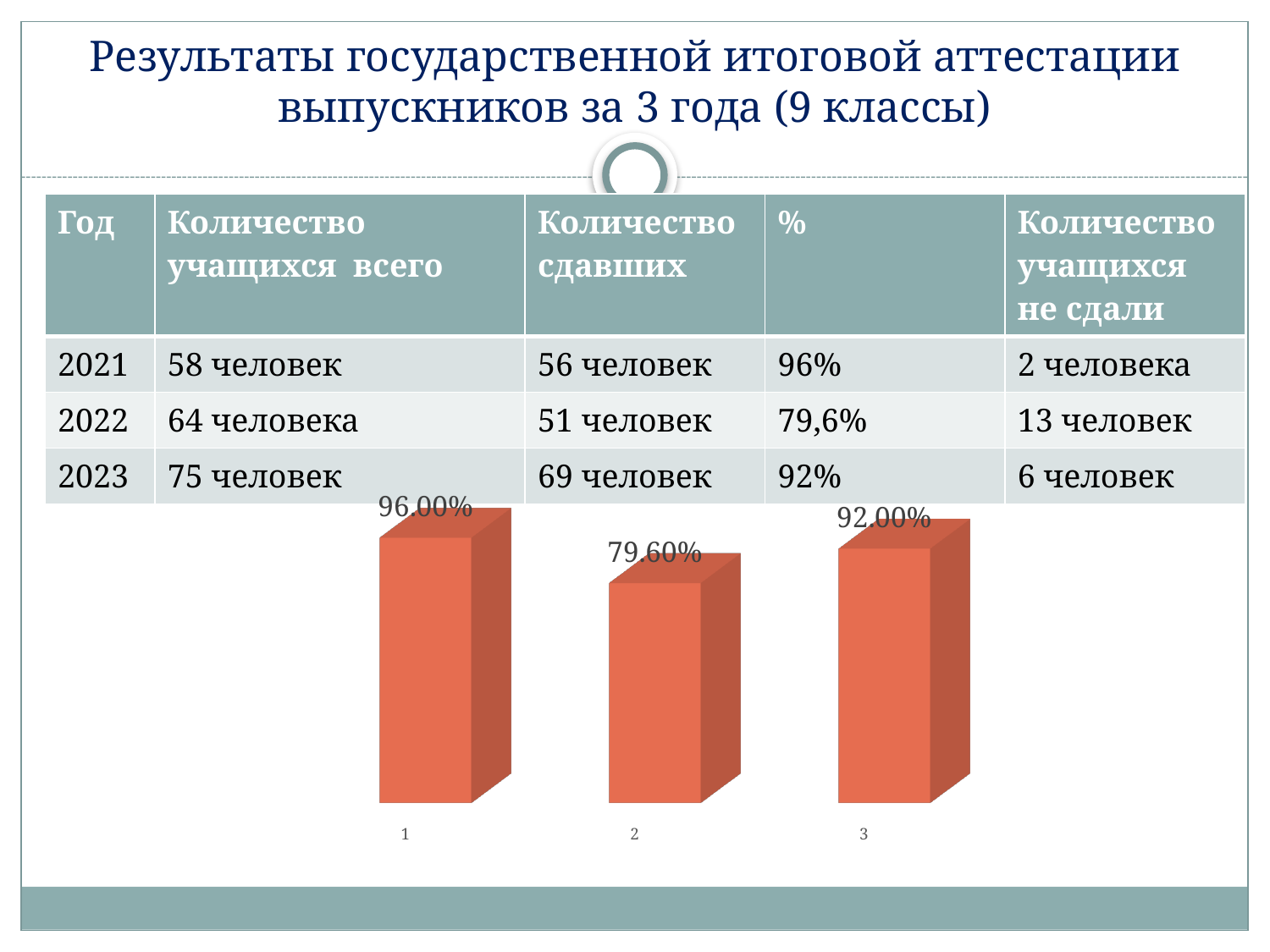
What is the difference between the values for category 3 and category 2? 12.40% Which is larger, the value for category 1 or the value for category 3? category 1 Which category has the lowest value in the chart? 2 What is the value shown for category 3 in the chart? 92.00% What is the value shown for category 2 in the chart? 79.60% Which category has the highest value in the chart? 1 What is the difference between the values for category 1 and category 2? 16.40% What type of chart is shown on the slide? bar chart How many bars does the chart have? 3 What colour are the bars in the chart? orange-red What is the value shown for category 1 in the chart? 96.00% Do the values rise or fall from category 1 to category 2? fall